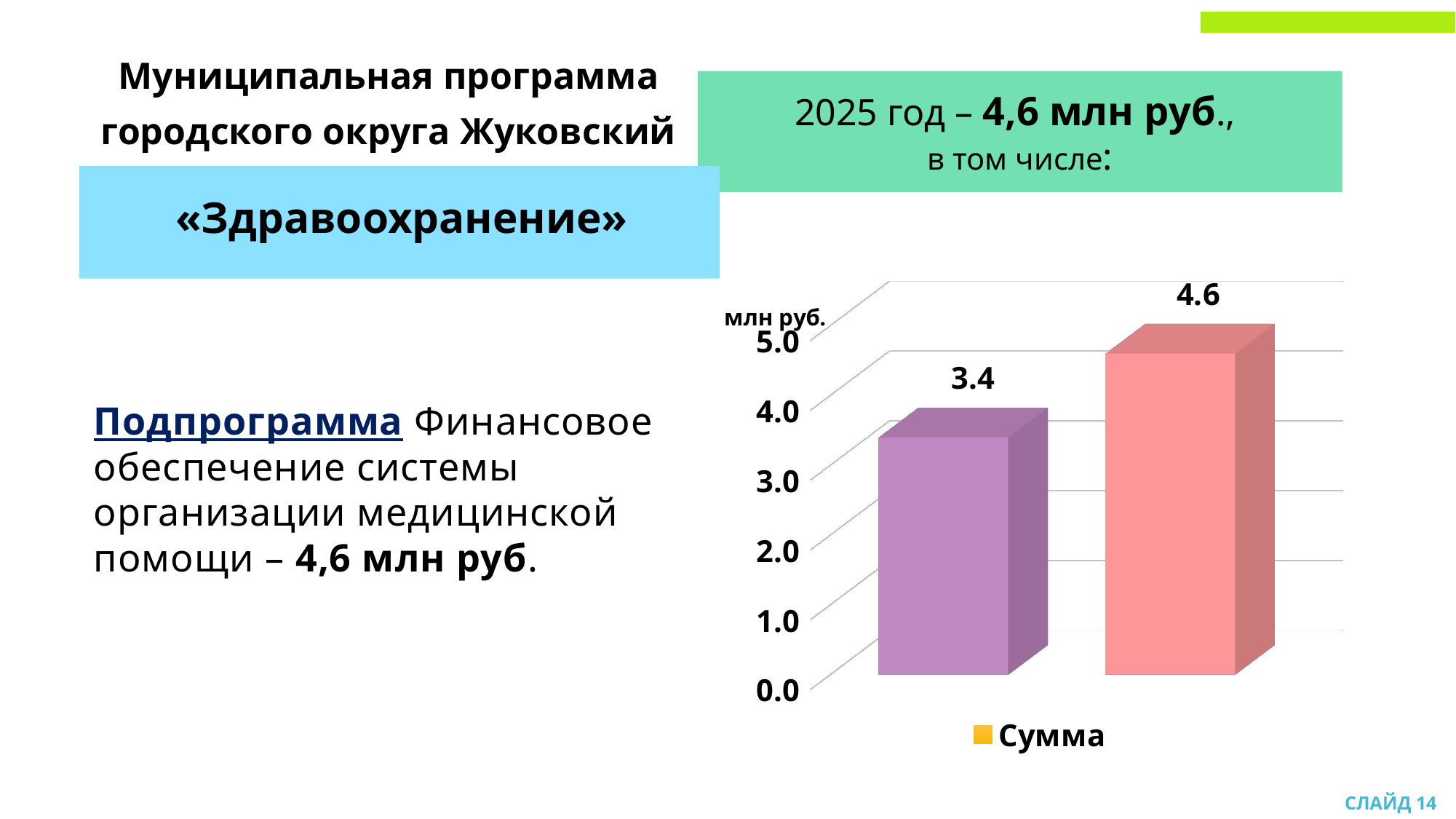
Do the values rise or fall from the left bar to the right bar? rise What is the difference between the right bar (4.6) and the left bar (3.4)? 1.2 Is the value of the left bar larger or smaller than the value of the right bar? smaller How many bars are plotted in the chart? 2 What is the value shown on the left (purple) bar of the chart? 3.4 Is the value of the right bar greater or less than 4.0? greater What is the name of the series shown in the chart legend? Сумма How many series does the chart legend list? 1 Which bar has the lowest value, the left or the right one? the left one What kind of chart is shown on the slide? bar chart What is the value shown on the right (pink) bar of the chart? 4.6 Which bar has the highest value, the left or the right one? the right one